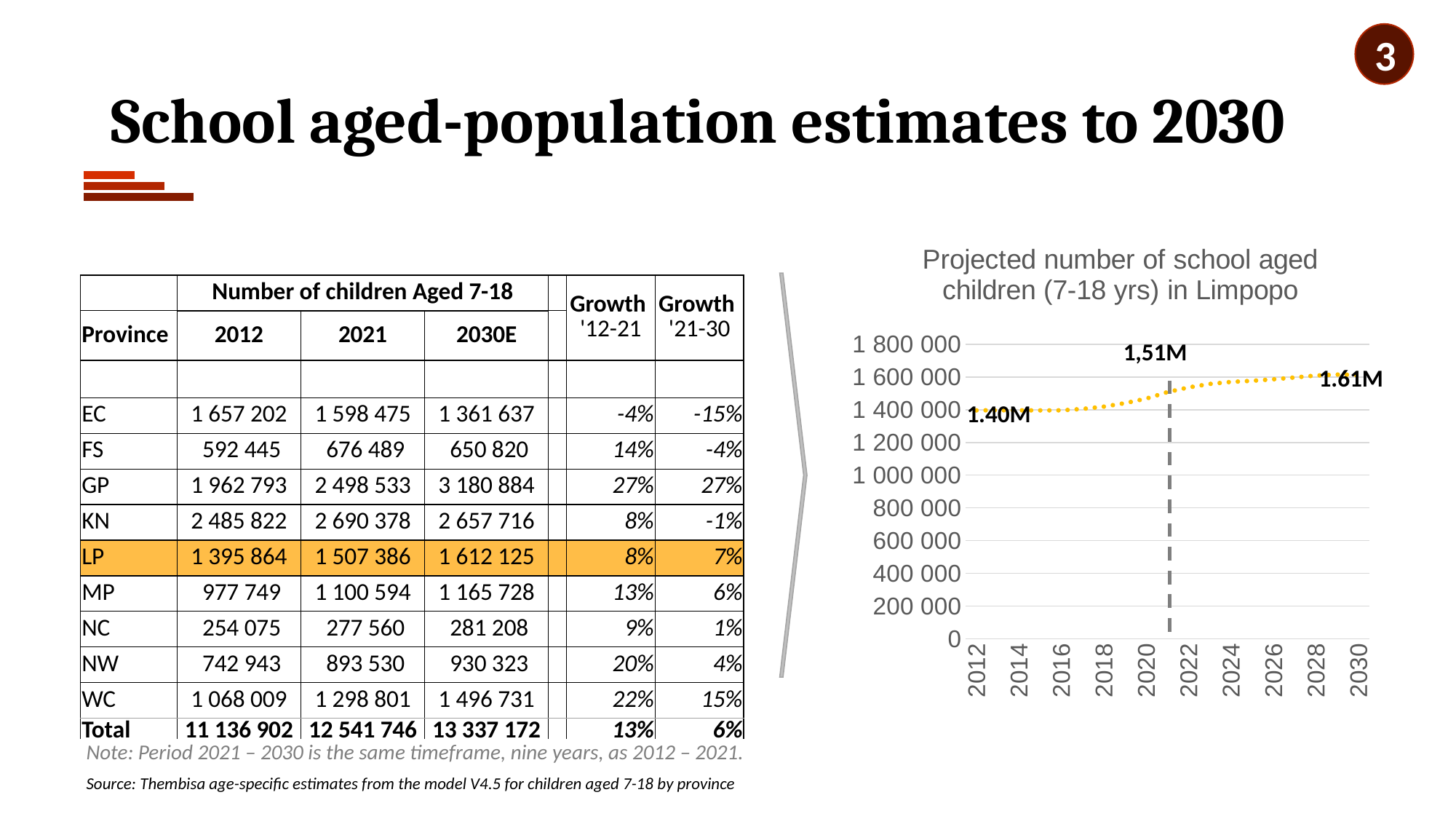
In the Limpopo chart, which is larger, the value for 2021 or the value for 2012? 2021 In the Limpopo chart, which labelled year has the highest value? 2030 In the Limpopo chart, what is the labelled value for 2030? 1.61M In the Limpopo chart, is the value for 2030 greater or less than 1 800 000? less In the Limpopo chart, what is the labelled value for 2021? 1,51M In the Limpopo chart, is the value for 2012 greater or less than 1 200 000? greater What is the title of the chart on the right of the slide? Projected number of school aged children (7-18 yrs) in Limpopo In the Limpopo chart, what is the difference between the labelled values for 2030 and 2012? 0.21M What kind of chart is shown on the right of the slide? line chart In the Limpopo chart, do the values rise or fall from 2012 to 2030? rise In the chart 'Projected number of school aged children (7-18 yrs) in Limpopo', what is the labelled value for 2012? 1.40M In the Limpopo chart, which labelled year has the lowest value? 2012